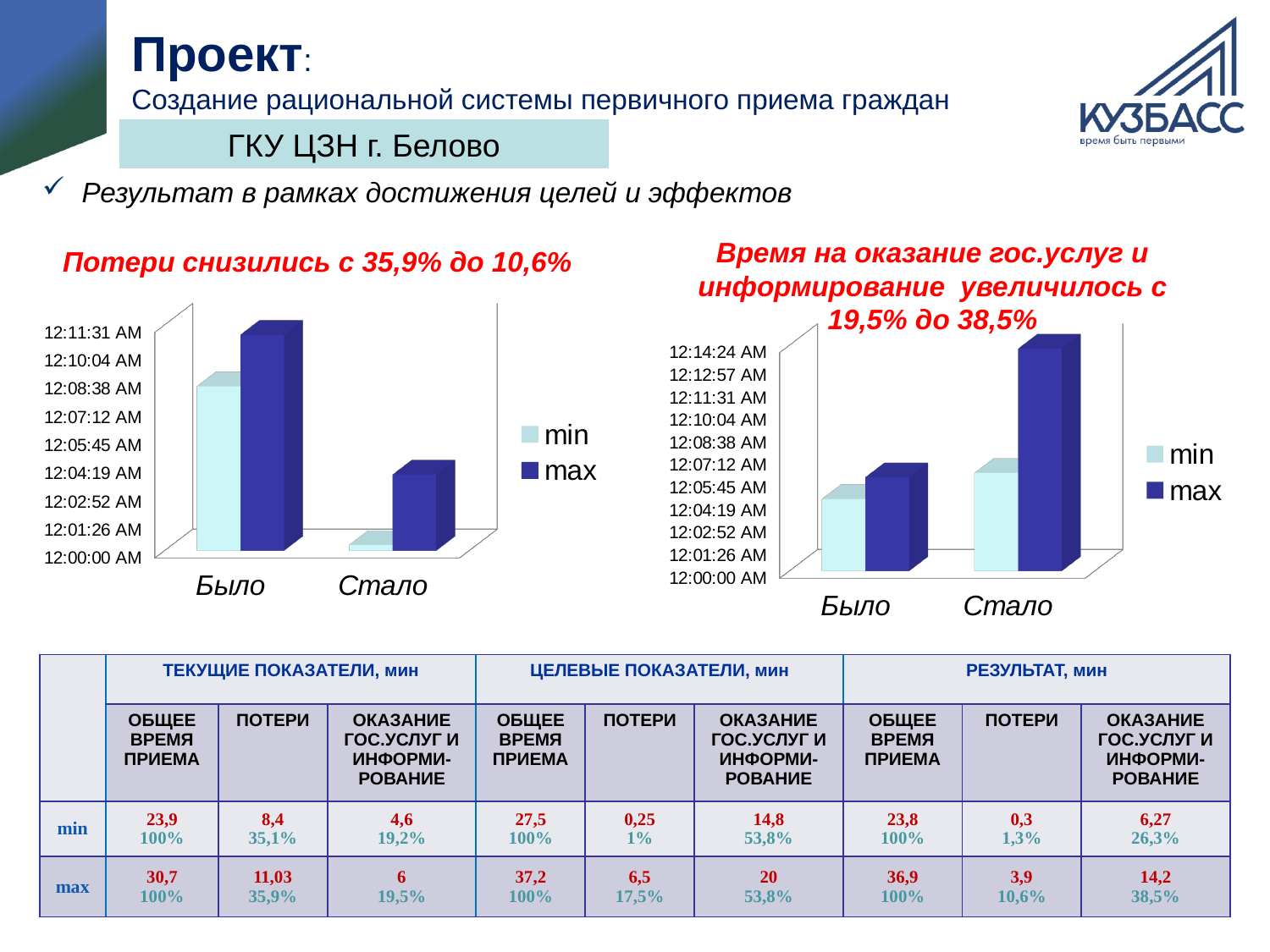
In the left chart, which category has the lowest bar overall? Стало In the left chart, which category has the taller "max" bar, Было or Стало? Было What is the title of the left chart? Потери снизились с 35,9% до 10,6% How many series does the legend of the left chart list? 2 In the left chart, does the "max" series rise or fall from Было to Стало? fall In the right chart, does the "max" series rise or fall from Было to Стало? rise In the right chart, which category has the larger "min" value, Было or Стало? Стало In the right chart, which category has the tallest bar overall? Стало In the left chart, which category has the larger "min" value, Было or Стало? Было What kind of chart is the left chart titled "Потери снизились с 35,9% до 10,6%"? bar chart How many categories are shown on the x axis of the right chart? 2 What are the legend entries of the right chart? min, max